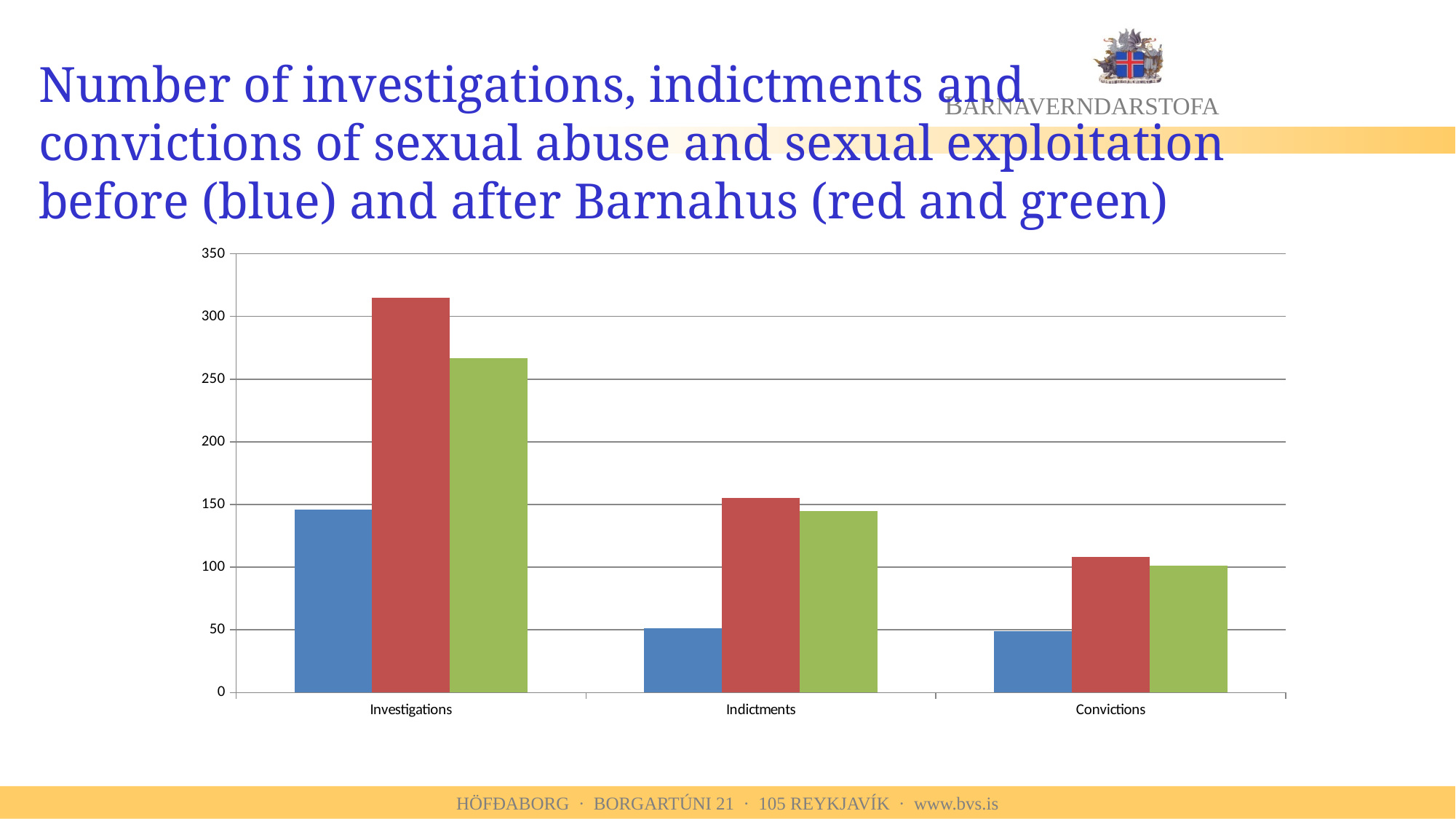
Is the blue bar for Investigations taller or shorter than the blue bar for Indictments? taller Is the value of the red bar for Investigations greater or less than 300? greater Within the Investigations category, which bar is taller: the red bar or the green bar? red Is the value of the red bar for Convictions greater or less than 150? less How many categories are shown on the x axis of the chart? 3 Is the value of the green bar for Investigations greater or less than 250? greater How many bars are shown for each category in the chart? 3 Which category has the tallest bar in the chart? Investigations According to the slide title, which colour represents the period before Barnahus? blue Do the red bars rise or fall moving from Investigations to Convictions along the x axis? fall What kind of chart is shown on the slide? bar chart